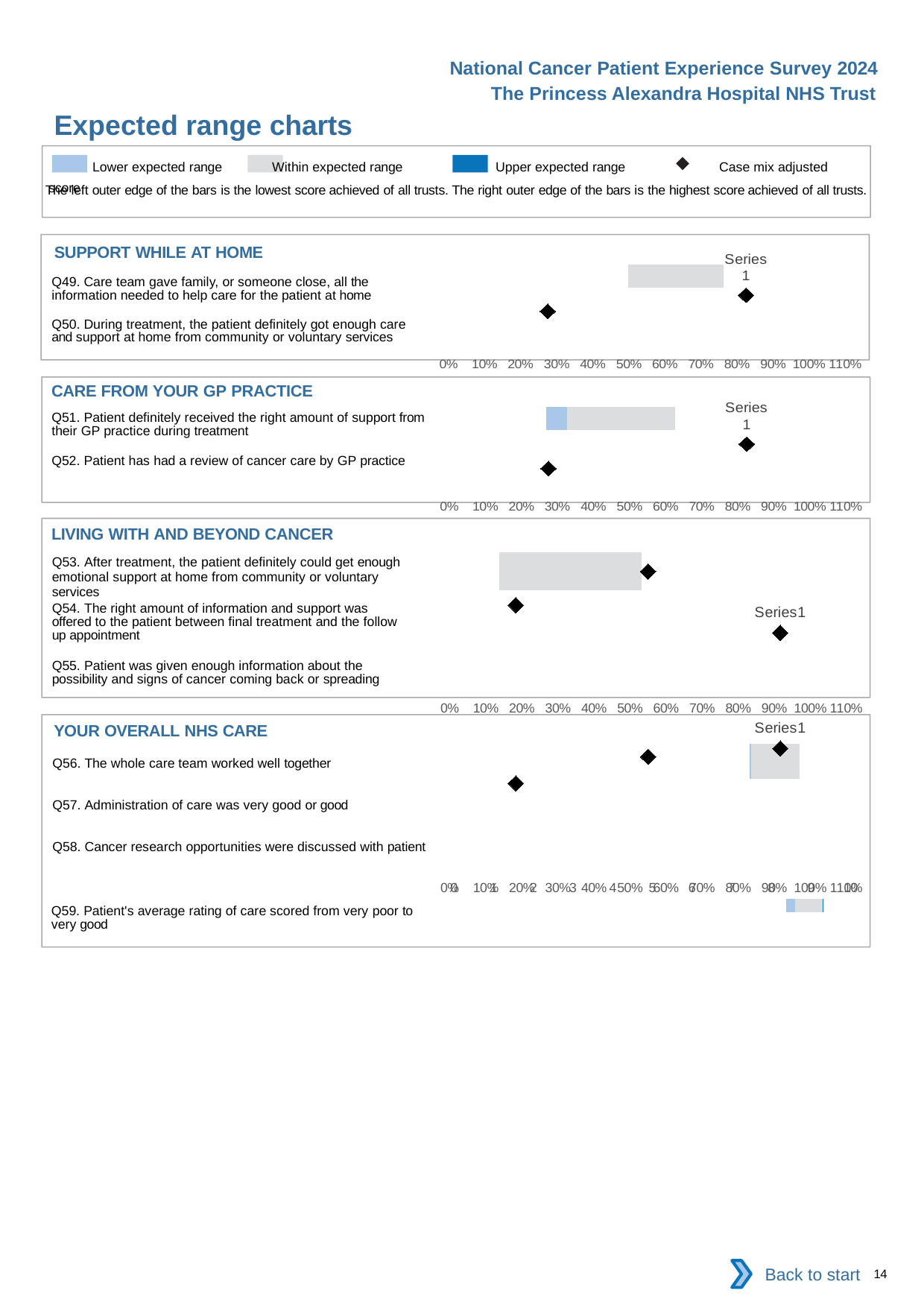
How many section charts (titled boxes) are shown on the slide? 4 In the 'SUPPORT WHILE AT HOME' chart, is the left edge of the grey 'within expected range' bar greater or less than 40%? greater In the 'CARE FROM YOUR GP PRACTICE' chart, is the right edge of the expected range bar greater or less than 70%? less According to the legend, what does the black diamond marker represent? Case mix adjusted score According to the legend, what does the grey bar colour represent? Within expected range How many questions are listed in the 'LIVING WITH AND BEYOND CANCER' section? 3 How many questions are listed in the 'YOUR OVERALL NHS CARE' section? 4 How many entries does the legend at the top of the slide list? 4 What kind of chart is used in the 'SUPPORT WHILE AT HOME' section? bar chart What is the highest tick label shown on the x axis of the 'CARE FROM YOUR GP PRACTICE' chart? 110%